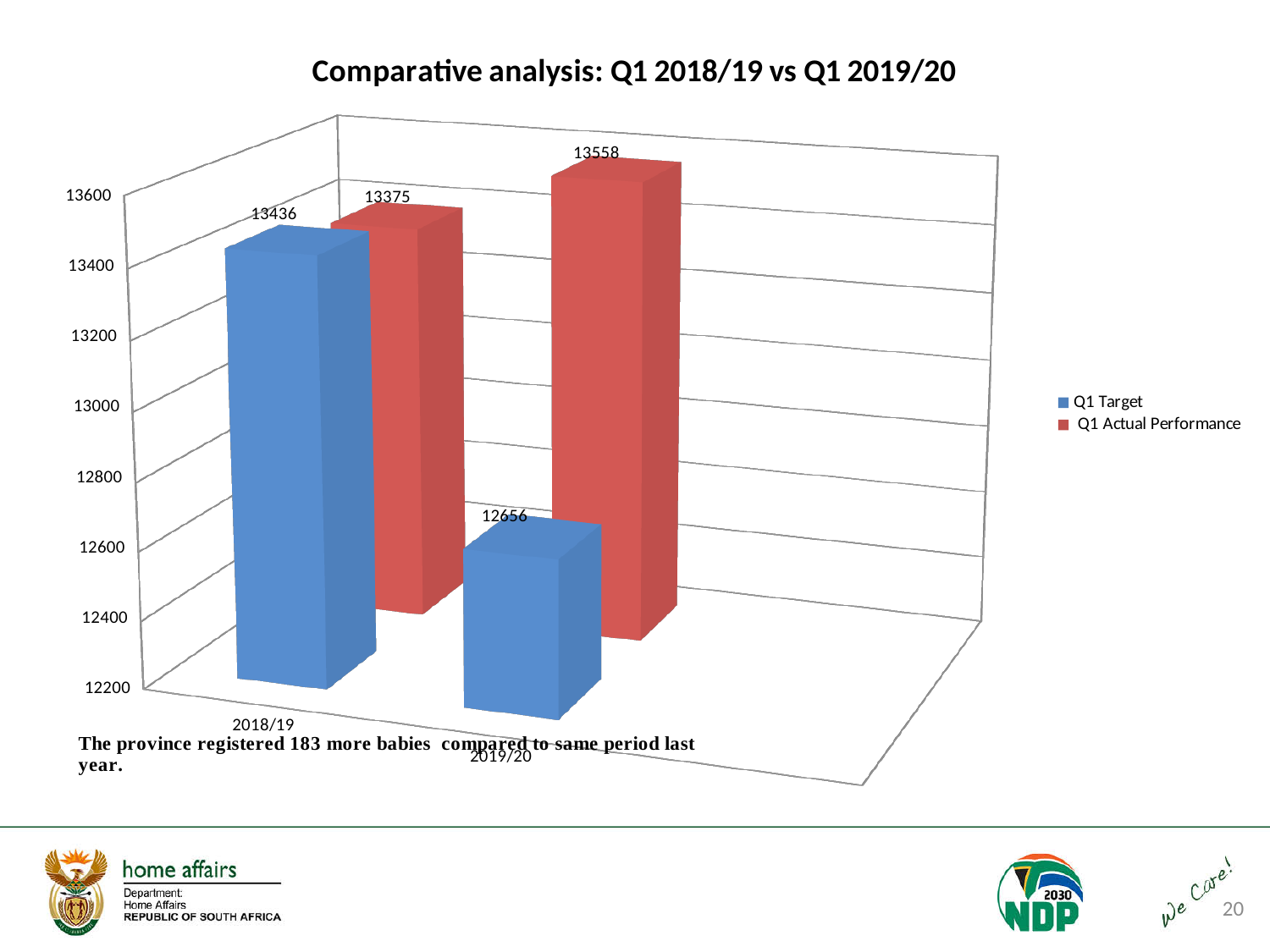
What kind of chart is shown on the slide? Bar chart What is the Q1 Actual Performance value for 2019/20? 13558 How many series does the legend list? 2 What is the difference between Q1 Actual Performance in 2019/20 and Q1 Actual Performance in 2018/19? 183 Which bar has the highest value on the chart? Q1 Actual Performance for 2019/20 Which is larger for 2018/19: Q1 Target or Q1 Actual Performance? Q1 Target What is the title of the chart? Comparative analysis: Q1 2018/19 vs Q1 2019/20 Which bar has the lowest value on the chart? Q1 Target for 2019/20 What is the difference between the Q1 Target and Q1 Actual Performance for 2019/20? 902 What is the Q1 Actual Performance value for 2018/19? 13375 What is the Q1 Target value for 2019/20? 12656 What is the Q1 Target value for 2018/19? 13436